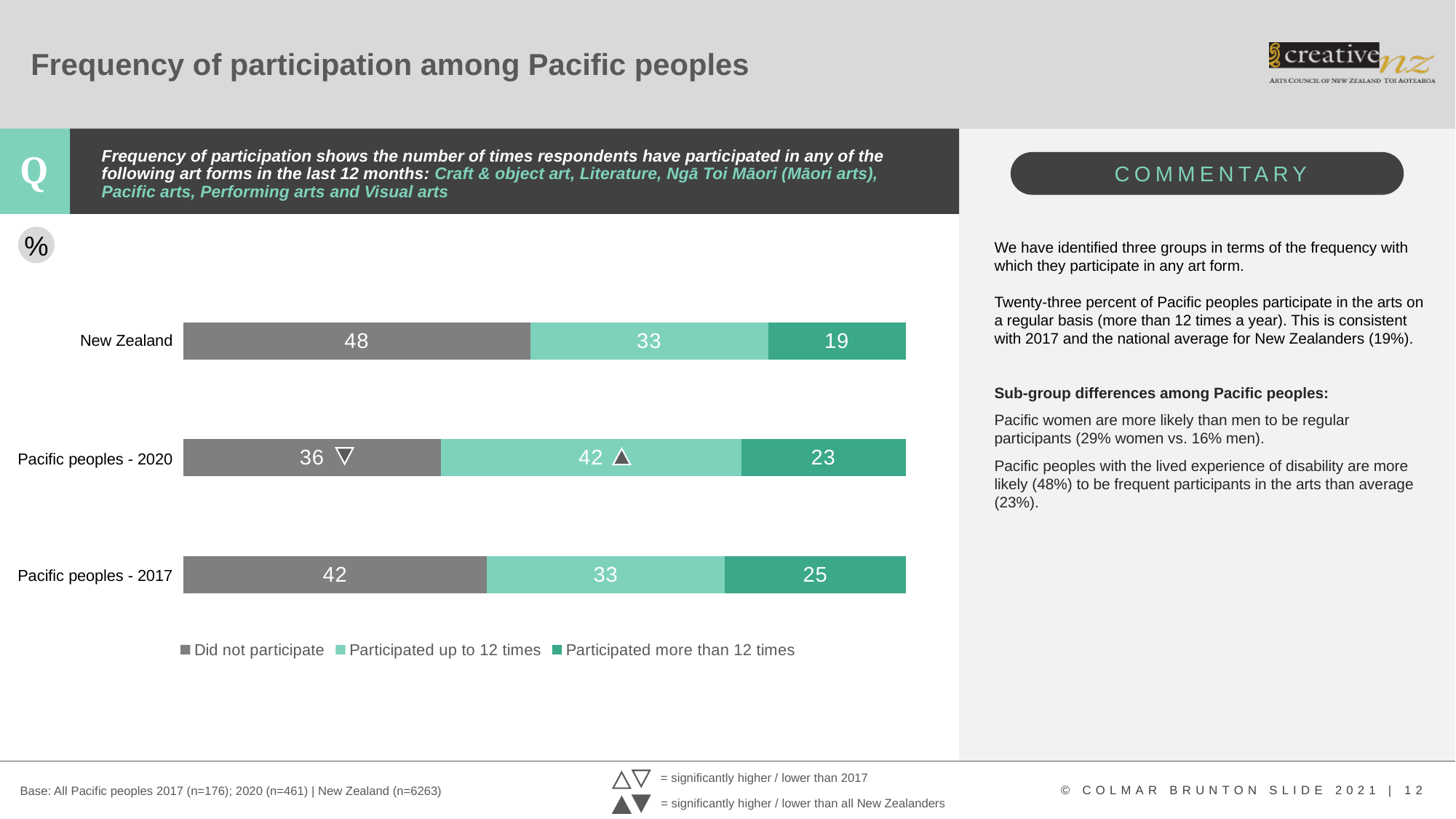
How many categories are shown on the chart? 3 How many series does the legend list? 3 Which series is shown in dark grey in the legend? Did not participate Which category has the lowest value for 'Participated more than 12 times'? New Zealand What is the total of the stacked bar for Pacific peoples - 2020? 101 What is the value for 'Participated more than 12 times' for Pacific peoples - 2017? 25 What kind of chart is shown on the slide? Stacked bar chart Which category has the highest value for 'Did not participate'? New Zealand What is the difference between the 'Did not participate' values for New Zealand and Pacific peoples - 2020? 12 What is the value for 'Did not participate' for New Zealand? 48 Which is larger: 'Participated up to 12 times' for Pacific peoples - 2020 or for Pacific peoples - 2017? Pacific peoples - 2020 What is the value for 'Participated up to 12 times' for Pacific peoples - 2020? 42